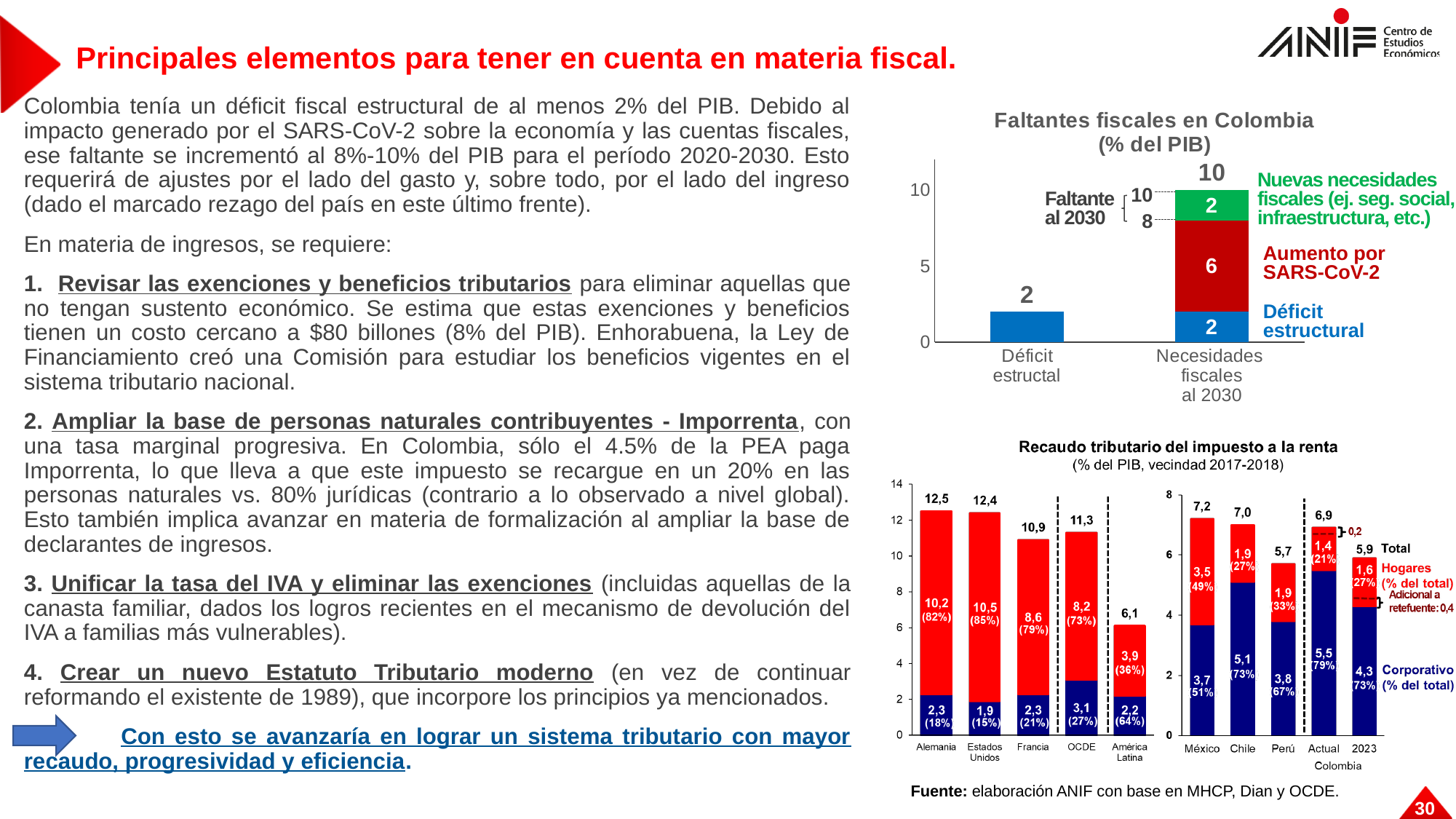
What type of chart is 'Faltantes fiscales en Colombia'? Bar chart In the 'Faltantes fiscales en Colombia' chart, what is the value of the 'Nuevas necesidades fiscales' segment? 2 In the 'Faltantes fiscales en Colombia' chart, what is the total of the 'Necesidades fiscales al 2030' stacked bar? 10 In the 'Recaudo tributario del impuesto a la renta' chart, which is larger, the total for Chile or the total for Perú? Chile In the 'Recaudo tributario del impuesto a la renta' chart, what is the total value for Alemania? 12,5 In the 'Recaudo tributario del impuesto a la renta' chart, what is the Corporativo value for OCDE? 3,1 In the 'Recaudo tributario del impuesto a la renta' chart, what is the difference between the totals of Colombia Actual and Colombia 2023? 1,0 In the 'Faltantes fiscales en Colombia' chart, what is the value of the 'Déficit estructal' bar? 2 In the 'Recaudo tributario del impuesto a la renta' chart, which country or region has the highest total? Alemania In the 'Recaudo tributario del impuesto a la renta' chart, what is the Corporativo value for Colombia Actual? 5,5 In the 'Recaudo tributario del impuesto a la renta' chart, what is the Hogares share of the total for Estados Unidos? 85% In the 'Faltantes fiscales en Colombia' chart, what is the value of the 'Aumento por SARS-CoV-2' segment? 6